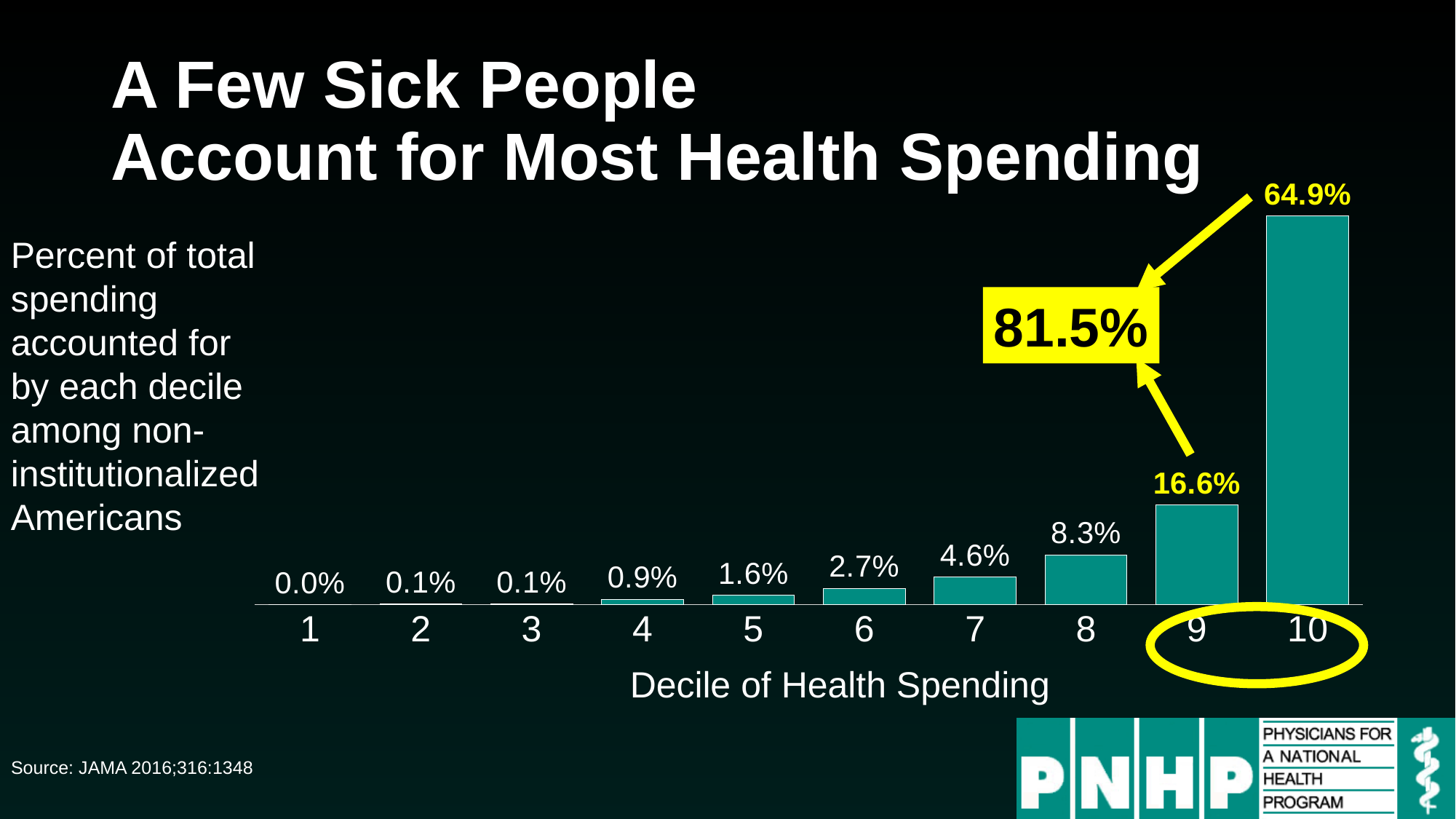
What percent of total spending is accounted for by decile 10? 64.9% What combined percentage is highlighted in the yellow box for deciles 9 and 10? 81.5% What is the value shown for decile 8? 8.3% What is the difference between the values for decile 10 and decile 9? 48.3% Which decile has the lowest value on the chart? 1 What kind of chart is shown on the slide? bar chart What percent of total spending is accounted for by decile 9? 16.6% How many deciles are shown on the x axis? 10 Which is larger, the value for decile 6 or the value for decile 7? decile 7 Which decile accounts for the highest share of total spending? 10 What is the difference between the values for decile 8 and decile 7? 3.7% What is the value shown for decile 5? 1.6%